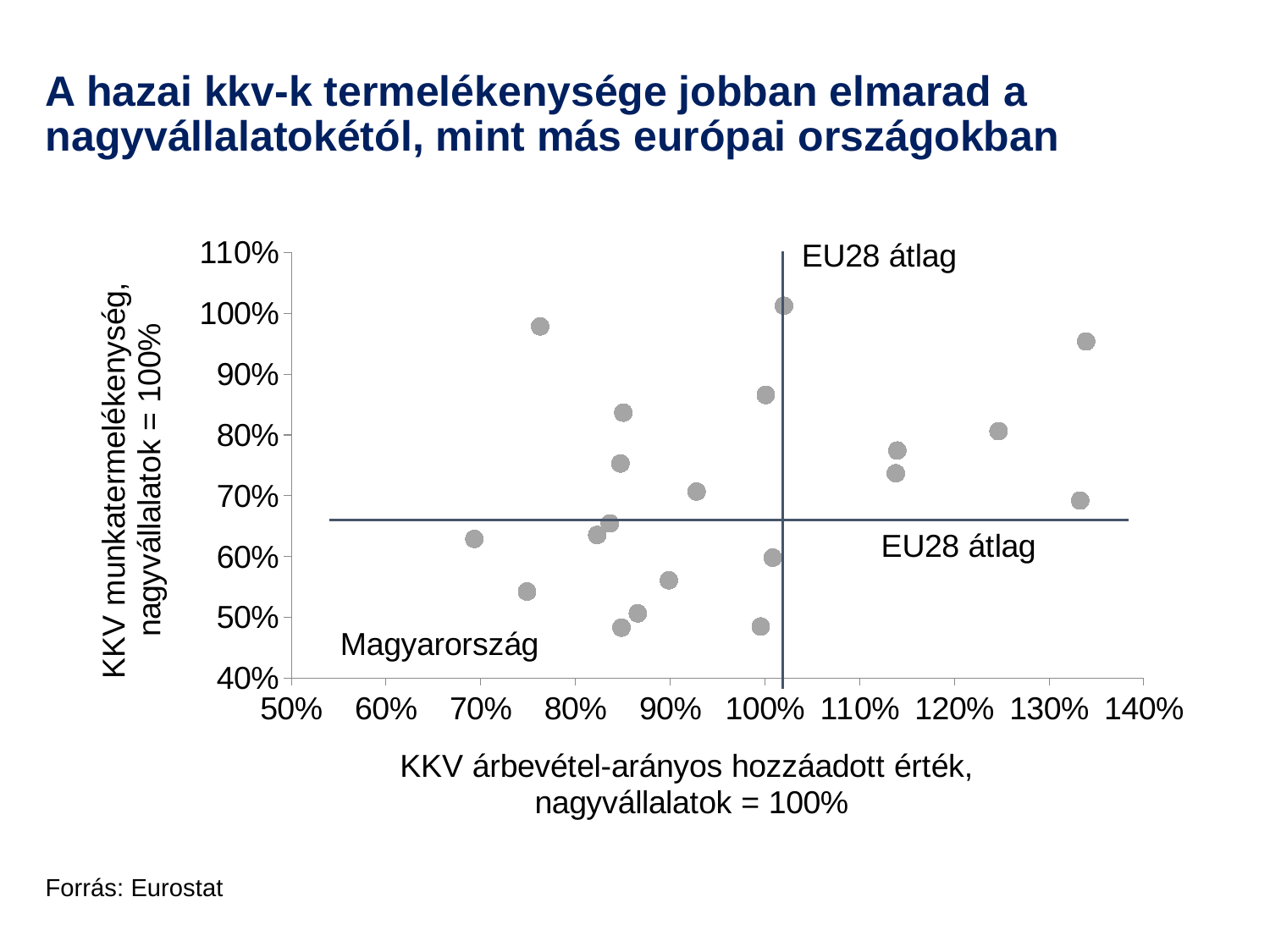
Is the y value of the lowest plotted point greater or less than 60%? less Is the y value of the highest plotted point greater or less than 90%? greater Is the x value of the rightmost plotted point greater or less than 120%? greater How many data points are plotted in the chart? 20 What label is attached to both the vertical and horizontal reference lines in the chart? EU28 átlag What is the title of the horizontal (x) axis of the chart? KKV árbevétel-arányos hozzáadott érték, nagyvállalatok = 100% What kind of chart is shown on the slide? scatter chart